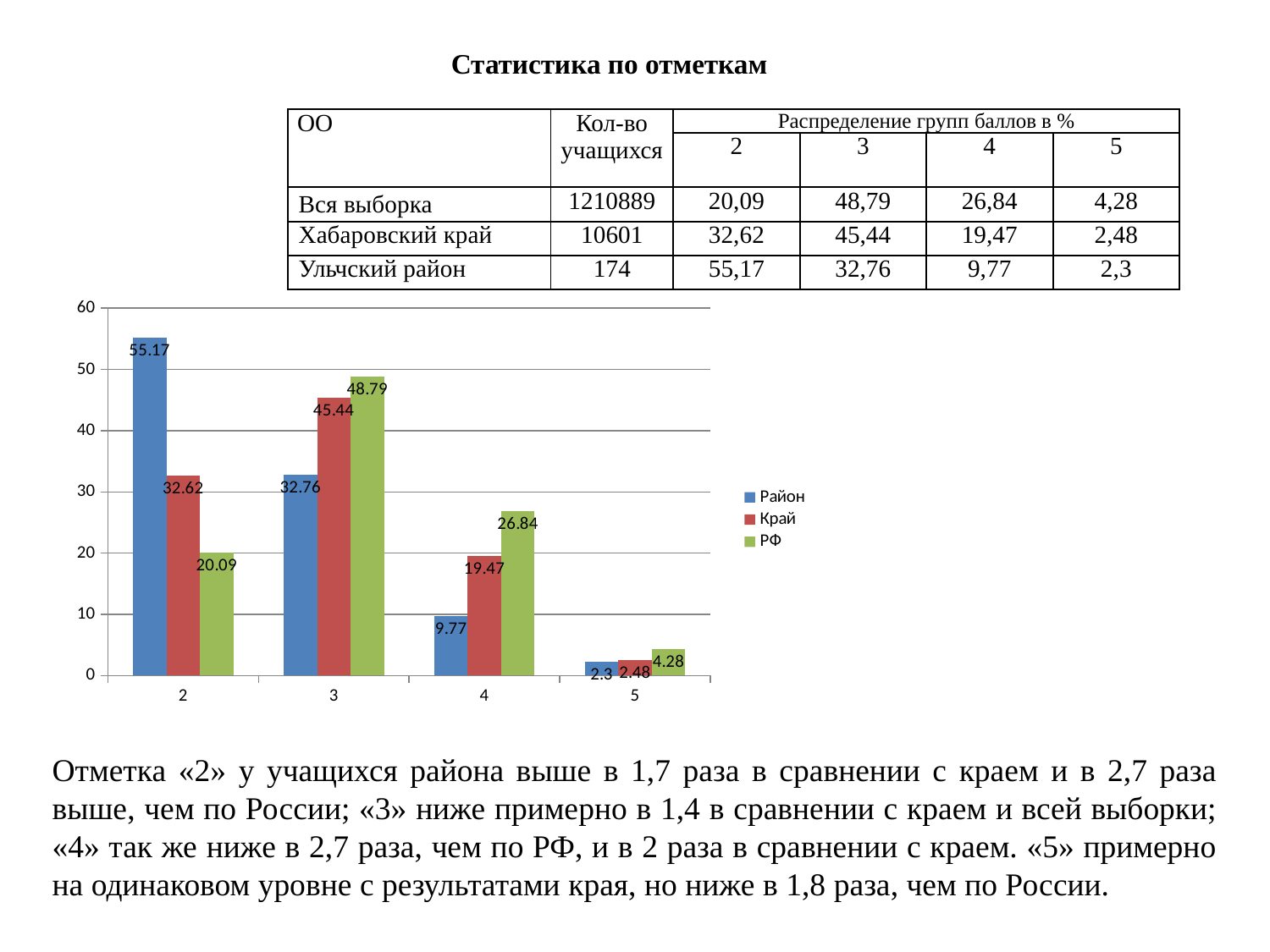
What is the value for Район at category 2? 55.17 How many categories are shown on the x axis of the chart? 4 What is the value for РФ at category 5? 4.28 What is the value for РФ at category 3? 48.79 What is the value for Край at category 4? 19.47 Which category has the highest value for the Район series? 2 What kind of chart is shown on the slide? bar chart How many series does the chart legend list? 3 Is the value for Район at category 4 greater or less than 10? less What is the difference between the Район and Край values at category 2? 22.55 Which category has the lowest value for the РФ series? 5 Which is larger at category 3: the value for Край or the value for РФ? РФ